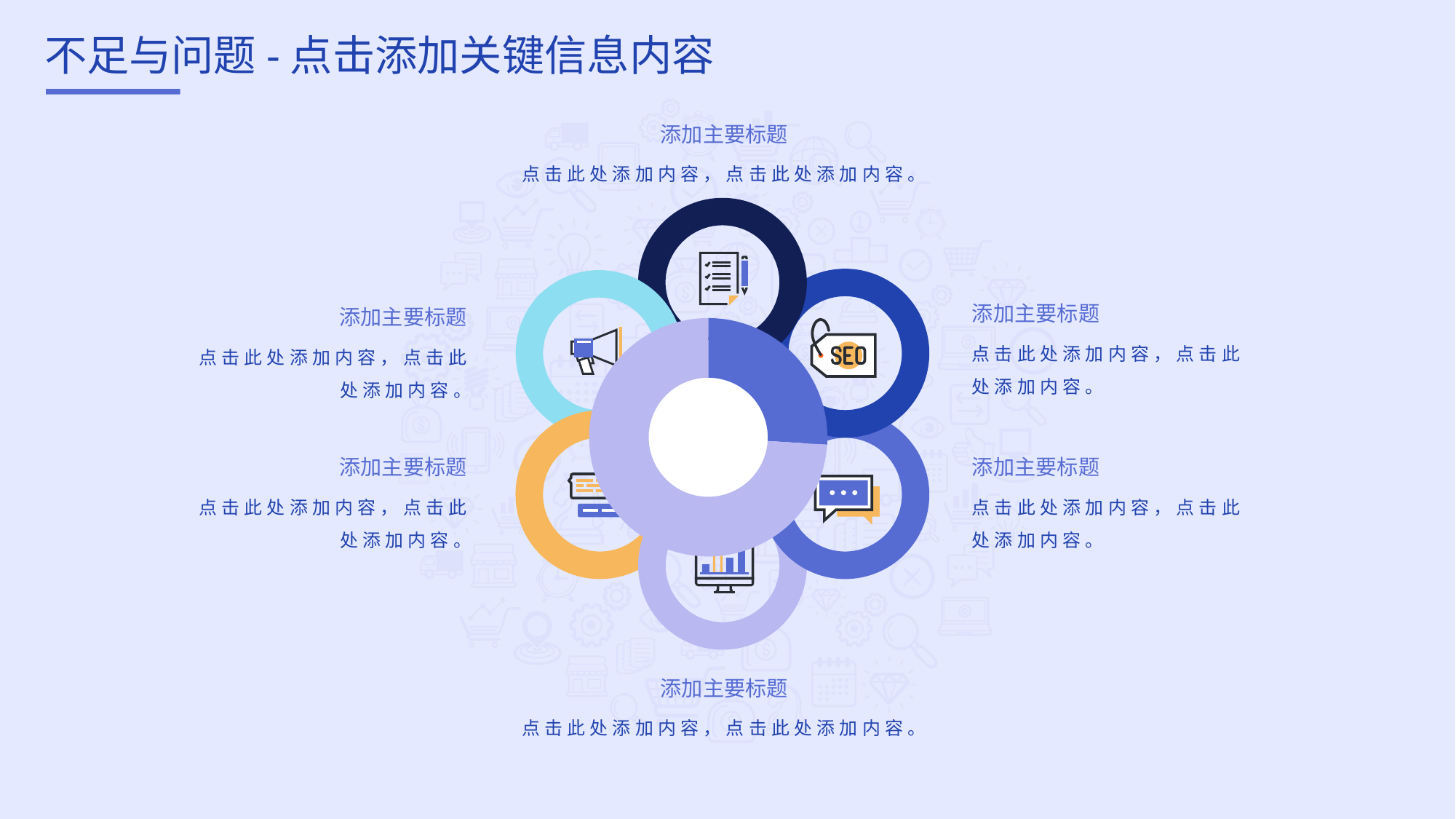
In the doughnut chart, which slice is the largest: the light lavender slice at the bottom, the medium blue slice on the right, or the light purple slice at the top left? The light lavender slice at the bottom How many slices does the doughnut chart in the centre of the slide have? 3 Does the doughnut chart on the slide show any data labels or a legend? No What kind of chart is shown in the centre of the slide? Doughnut (pie) chart